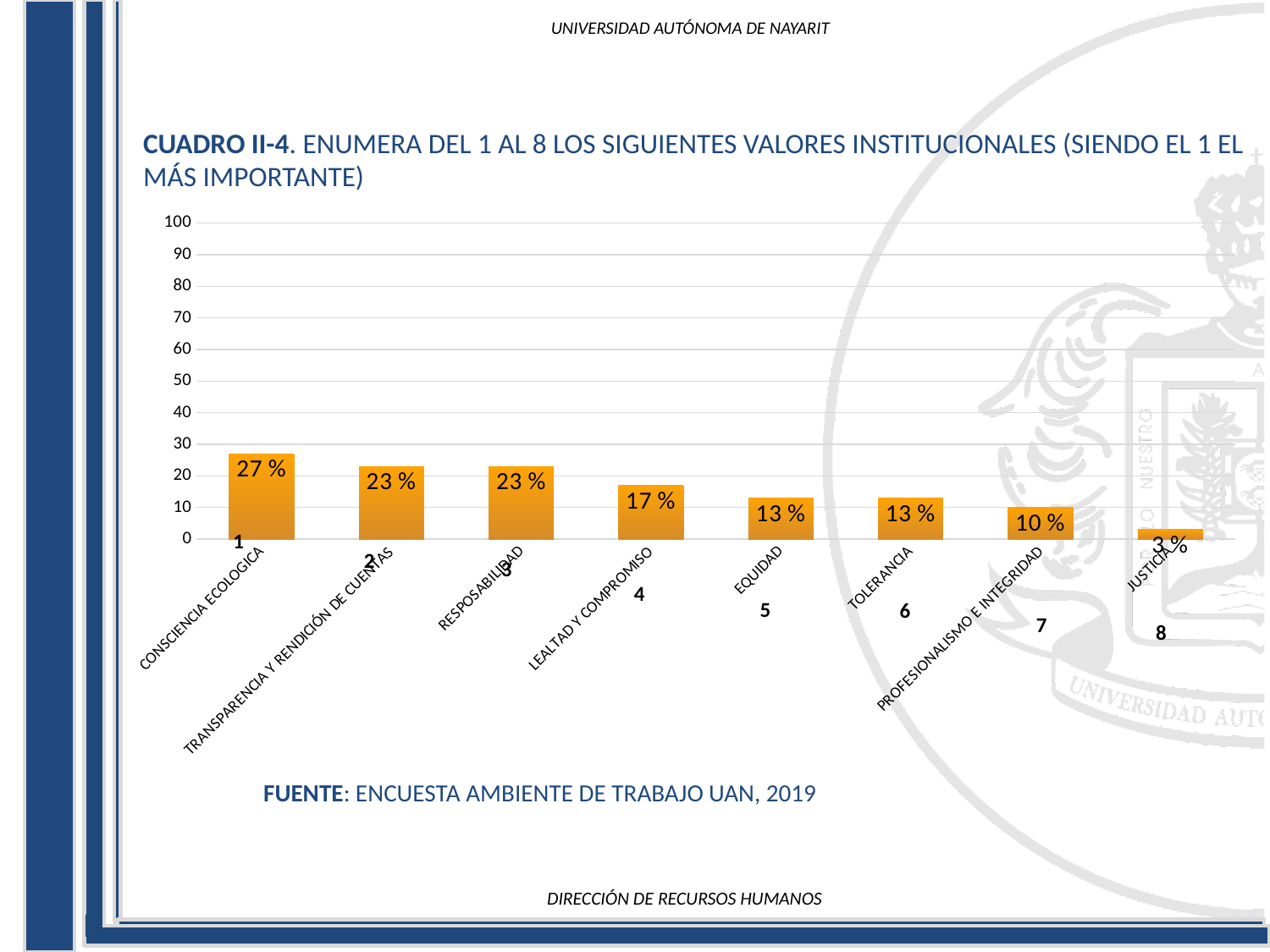
What is the value for CONSCIENCIA ECOLOGICA? 27 % Is the value for TRANSPARENCIA Y RENDICIÓN DE CUENTAS greater or less than 30? less Which is larger, the value for EQUIDAD or the value for PROFESIONALISMO E INTEGRIDAD? EQUIDAD How many categories are shown on the x axis? 8 What is the value for LEALTAD Y COMPROMISO? 17 % Which category has the lowest value? JUSTICIA What kind of chart is shown on the slide? bar chart Do the values rise or fall from left to right along the x axis? fall What is the difference between the values for CONSCIENCIA ECOLOGICA and LEALTAD Y COMPROMISO? 10 % Which category has the highest value? CONSCIENCIA ECOLOGICA What is the value for JUSTICIA? 3 % What is the value for PROFESIONALISMO E INTEGRIDAD? 10 %